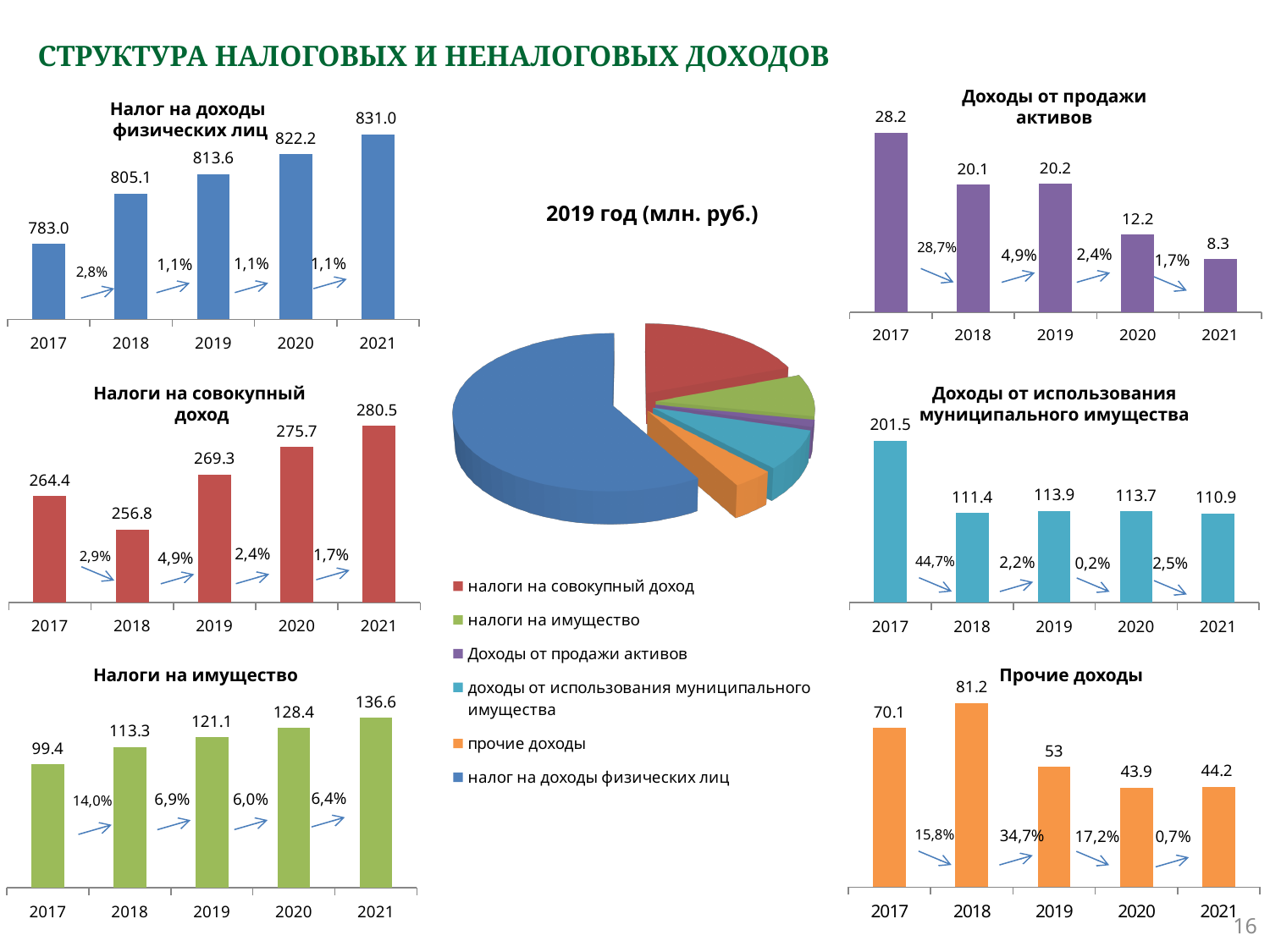
What kind of chart is the chart titled "Прочие доходы"? bar chart In the chart titled "Налоги на совокупный доход", what is the difference between the 2021 and 2017 values? 16.1 In the chart titled "Налог на доходы физических лиц", what is the value for 2021? 831.0 In the chart titled "Налог на доходы физических лиц", do the values rise or fall from 2017 to 2021? rise In the chart titled "Прочие доходы", what is the value for 2018? 81.2 In the chart titled "Налоги на совокупный доход", which year has the lowest value? 2018 In the chart titled "Доходы от использования муниципального имущества", which is larger: the value for 2019 or the value for 2021? 2019 How many entries does the legend of the pie chart titled "2019 год (млн. руб.)" list? 6 In the chart titled "Доходы от продажи активов", what is the value for 2021? 8.3 In the chart titled "Налоги на имущество", how many years are shown on the x axis? 5 In the chart titled "Доходы от продажи активов", which year has the highest value? 2017 In the chart titled "Налоги на имущество", what is the value for 2017? 99.4